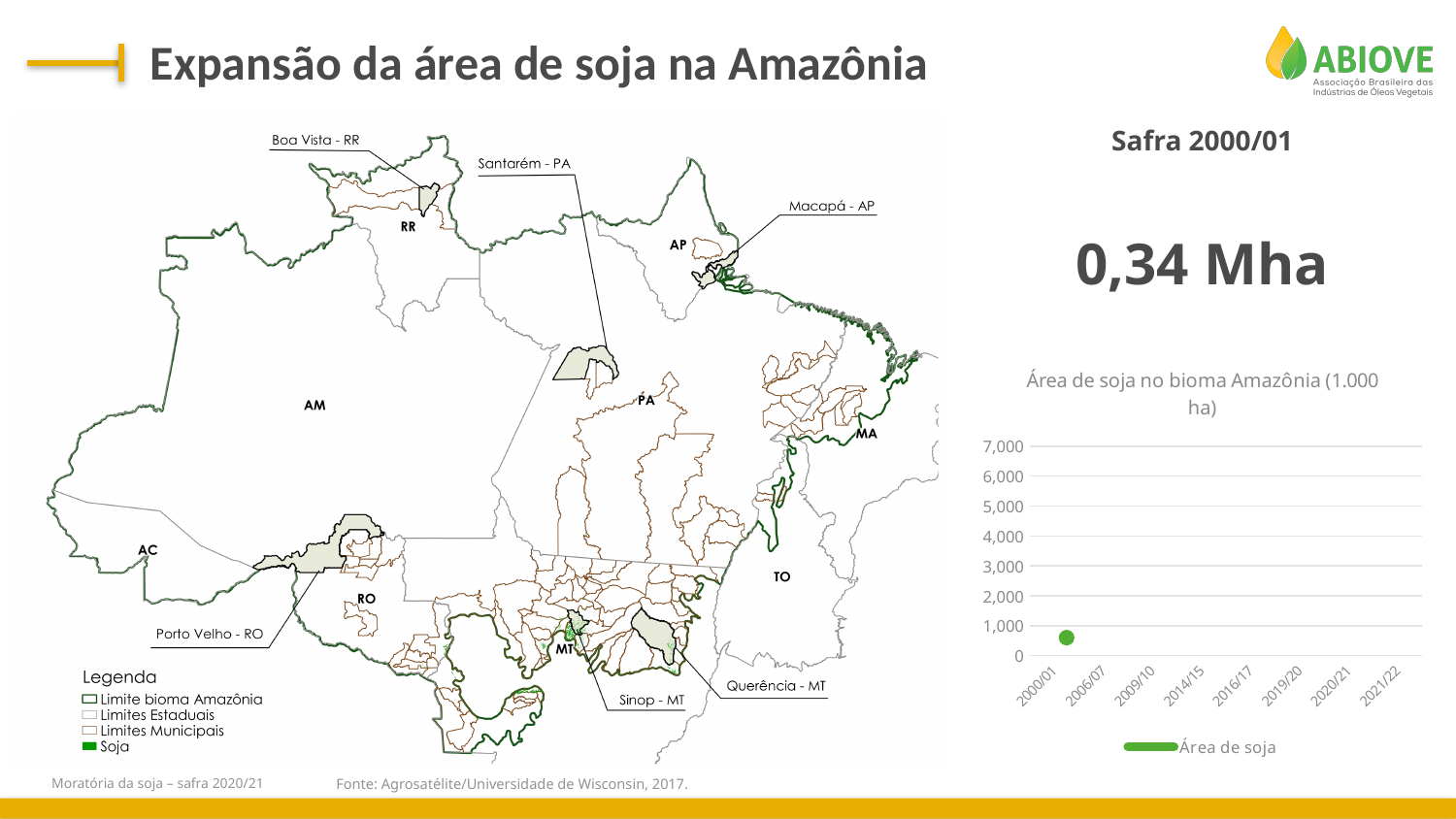
How many series does the legend of the chart on the right list? 1 In the chart on the right, is the value for 2000/01 greater or less than 2,000? less What is the title of the chart on the right side of the slide? Área de soja no bioma Amazônia (1.000 ha) What kind of chart is shown on the right side of the slide? line chart What is the name of the series shown in the legend of the chart on the right? Área de soja In the chart on the right, is the value for 2000/01 greater or less than 1,000? less In the chart on the right, which category has a plotted data point? 2000/01 How many data points are plotted in the chart on the right? 1 How many category labels are shown on the x axis of the chart on the right? 8